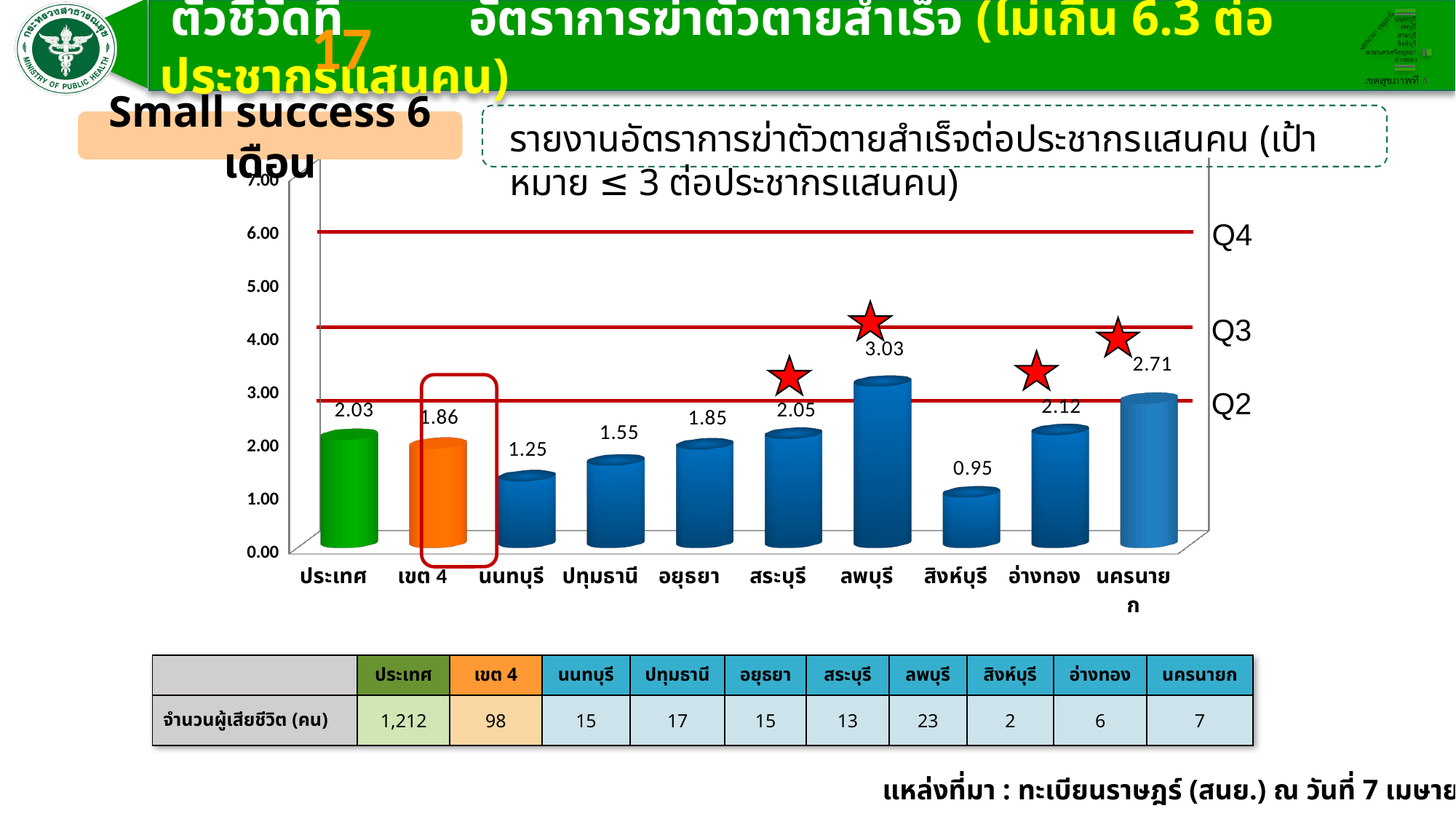
What is the difference between the values for ลพบุรี and สิงห์บุรี? 2.08 What is the difference between the values for ประเทศ and เขต 4? 0.17 What kind of chart is shown on the slide? bar chart How many categories are shown on the x axis of the chart? 10 What is the value for ลพบุรี? 3.03 What is the value for เขต 4? 1.86 What is the value for สิงห์บุรี? 0.95 Which is larger, the value for อ่างทอง or the value for ปทุมธานี? อ่างทอง Is the value for นนทบุรี greater or less than 2.00? less Which category has the highest value? ลพบุรี What is the value for นครนายก? 2.71 Which category has the lowest value? สิงห์บุรี